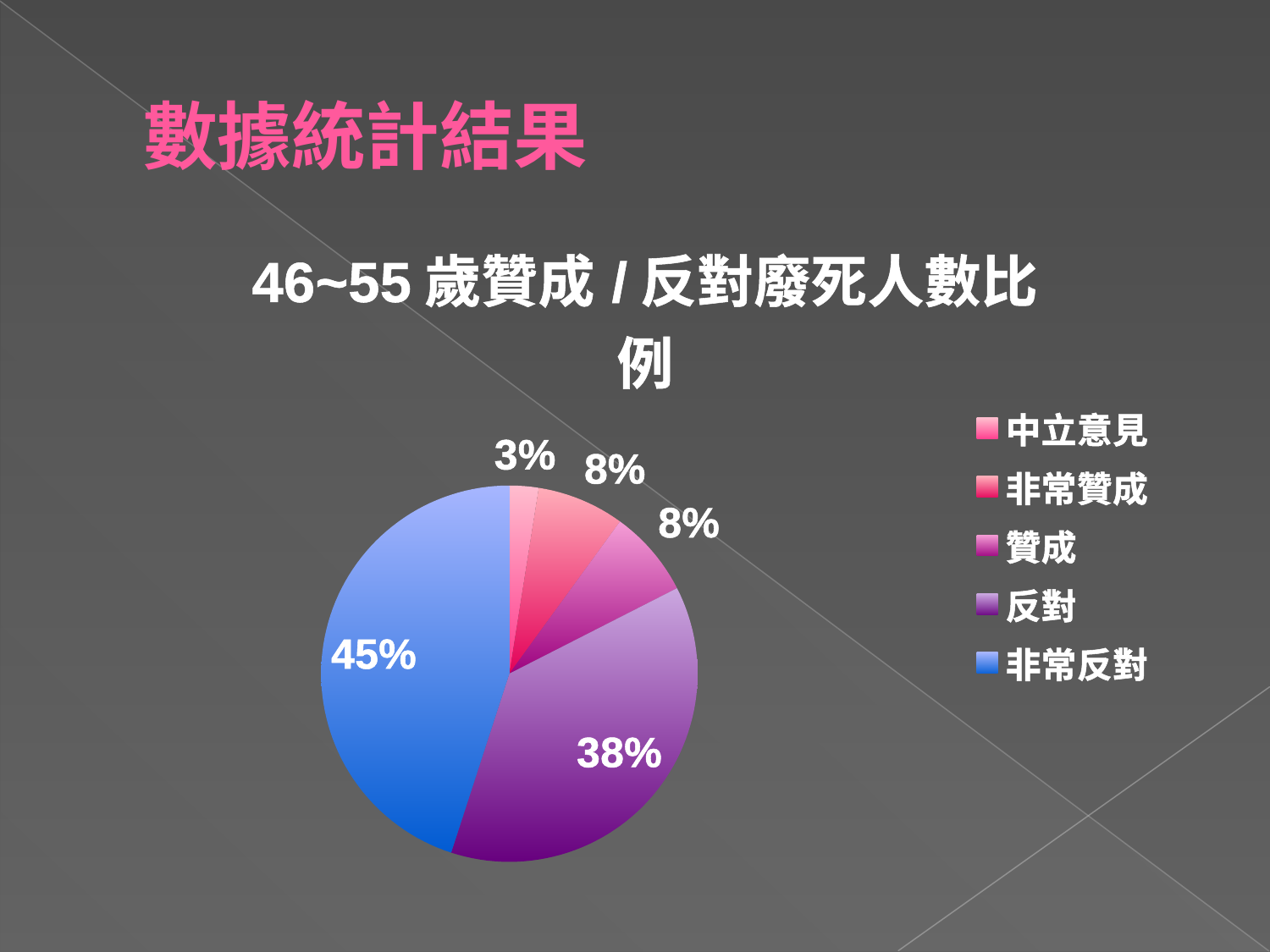
What percentage of the pie is 反對? 38% Which category has the largest share of the pie? 非常反對 How many categories does the legend list? 5 What is the title of the chart? 46~55 歲贊成 / 反對廢死人數比例 What percentage of the pie is 非常贊成? 8% What kind of chart is shown on the slide? pie chart What percentage of the pie is 中立意見? 3% Which is larger, the share for 反對 or the share for 贊成? 反對 What colour is the 非常反對 slice? blue Which category has the smallest share of the pie? 中立意見 What is the difference in percentage points between 非常反對 and 反對? 7 What percentage of the pie is 非常反對? 45%